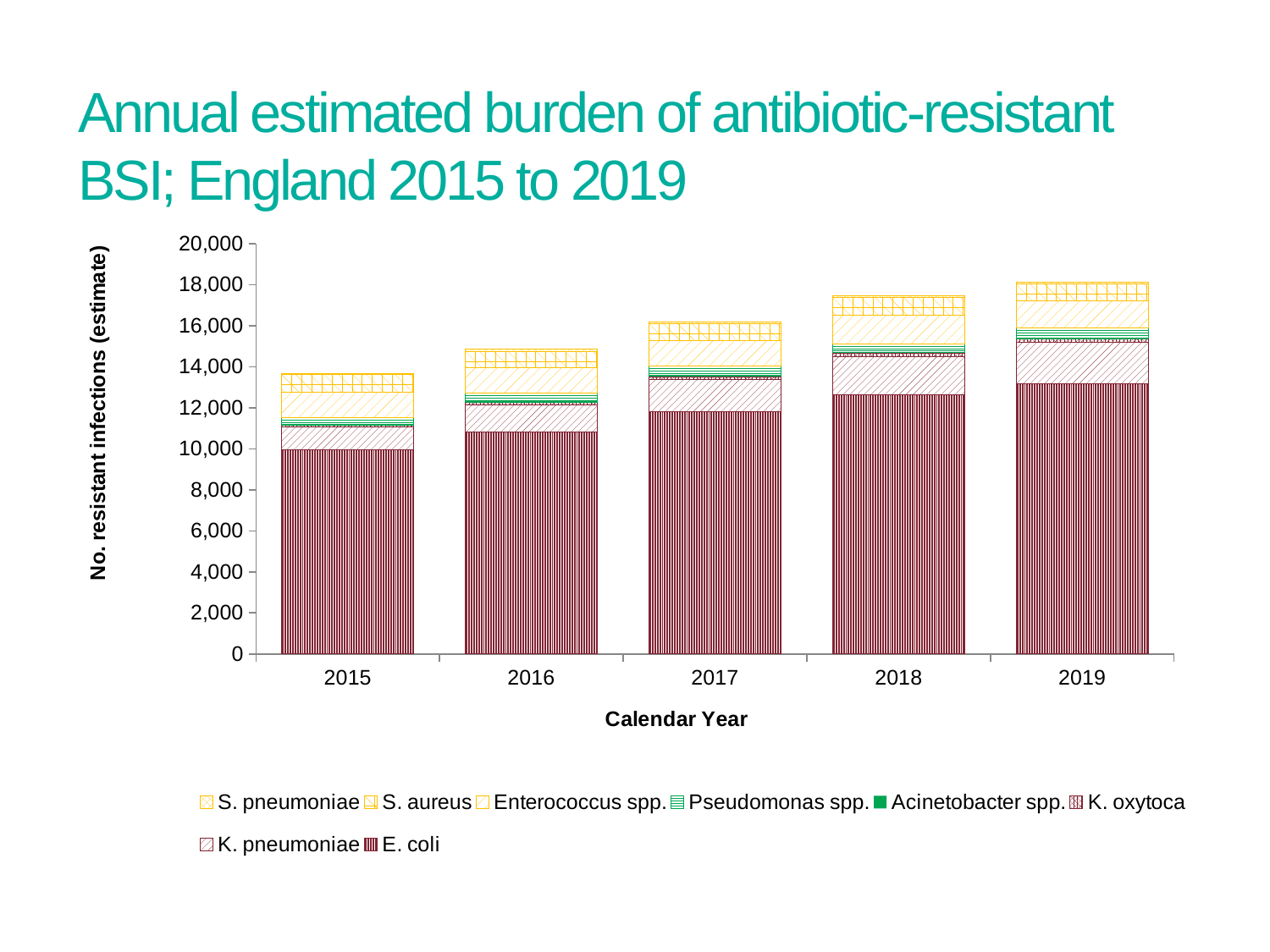
Is the E. coli value for 2019 greater or less than 12,000? greater What is the title of the y axis? No. resistant infections (estimate) Do the total estimated resistant infections rise or fall from 2015 to 2019? Rise Which year has the highest total estimated number of resistant infections? 2019 How many series does the legend list? 8 Is the total value for 2015 greater or less than 14,000? less Which year has a larger total of resistant infections, 2016 or 2018? 2018 Which year has the lowest total estimated number of resistant infections? 2015 How many calendar years are shown on the x axis? 5 Is the total value for 2018 greater or less than 16,000? greater Which series forms the largest segment of each bar? E. coli What kind of chart is shown on the slide? Stacked bar chart